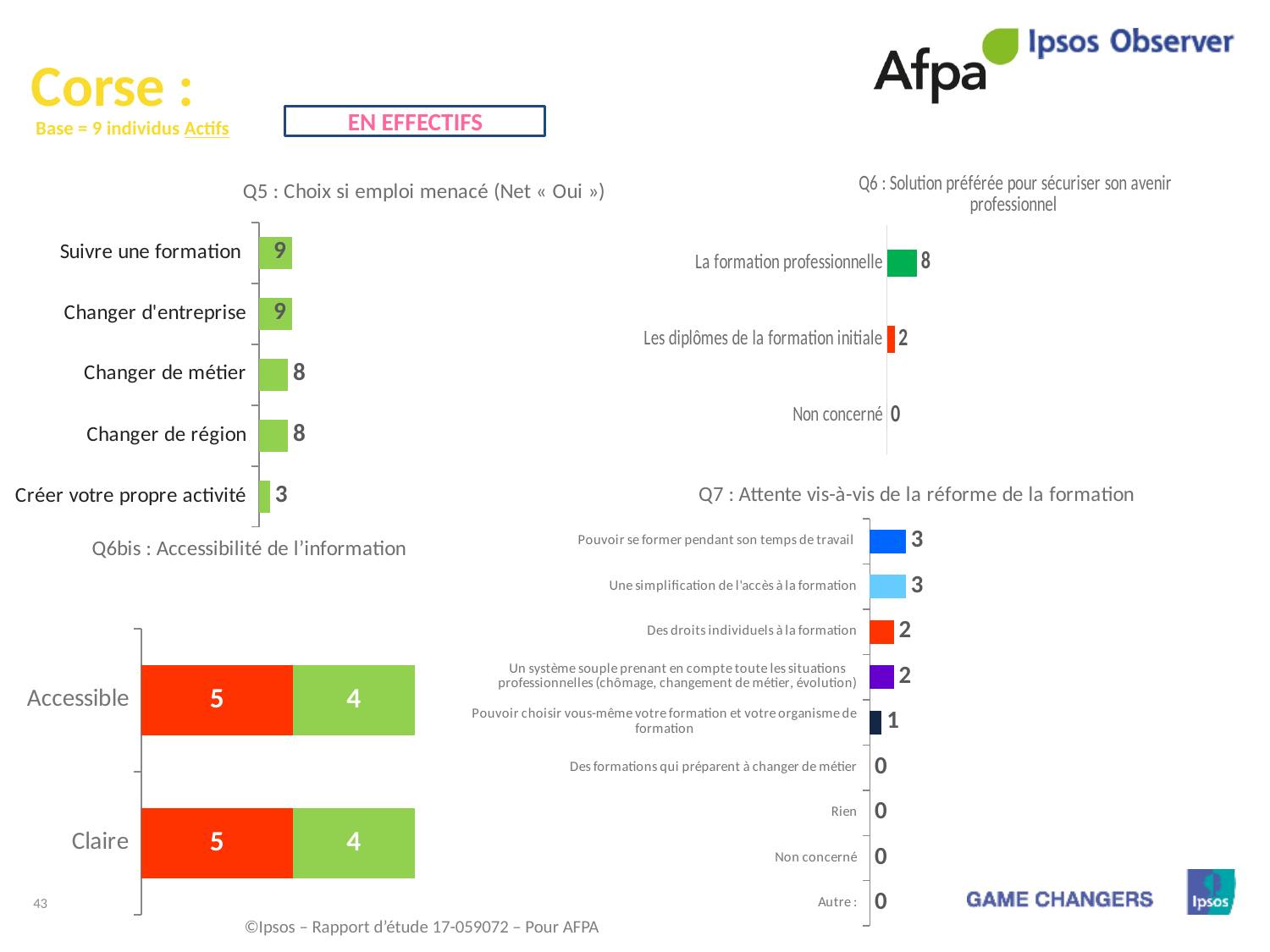
How many categories are shown in the Q7 chart (Attente vis-à-vis de la réforme de la formation)? 9 In the Q6bis chart (Accessibilité de l'information), what is the total of the stacked bar for "Accessible"? 9 In the Q6 chart (Solution préférée pour sécuriser son avenir professionnel), which category has the highest value? La formation professionnelle What type of chart is the Q6bis chart (Accessibilité de l'information)? Stacked bar chart In the Q6 chart (Solution préférée pour sécuriser son avenir professionnel), what is the value for "Non concerné"? 0 In the Q6bis chart (Accessibilité de l'information), what is the value of the orange segment for "Claire"? 5 In the Q5 chart (Choix si emploi menacé), what is the value for "Changer de métier"? 8 In the Q5 chart (Choix si emploi menacé), which category has the lowest value? Créer votre propre activité How many categories are shown in the Q5 chart (Choix si emploi menacé)? 5 In the Q6 chart (Solution préférée pour sécuriser son avenir professionnel), what is the value for "La formation professionnelle"? 8 In the Q7 chart (Attente vis-à-vis de la réforme de la formation), what is the value for "Pouvoir choisir vous-même votre formation et votre organisme de formation"? 1 In the Q5 chart (Choix si emploi menacé), what is the difference between "Suivre une formation" and "Créer votre propre activité"? 6